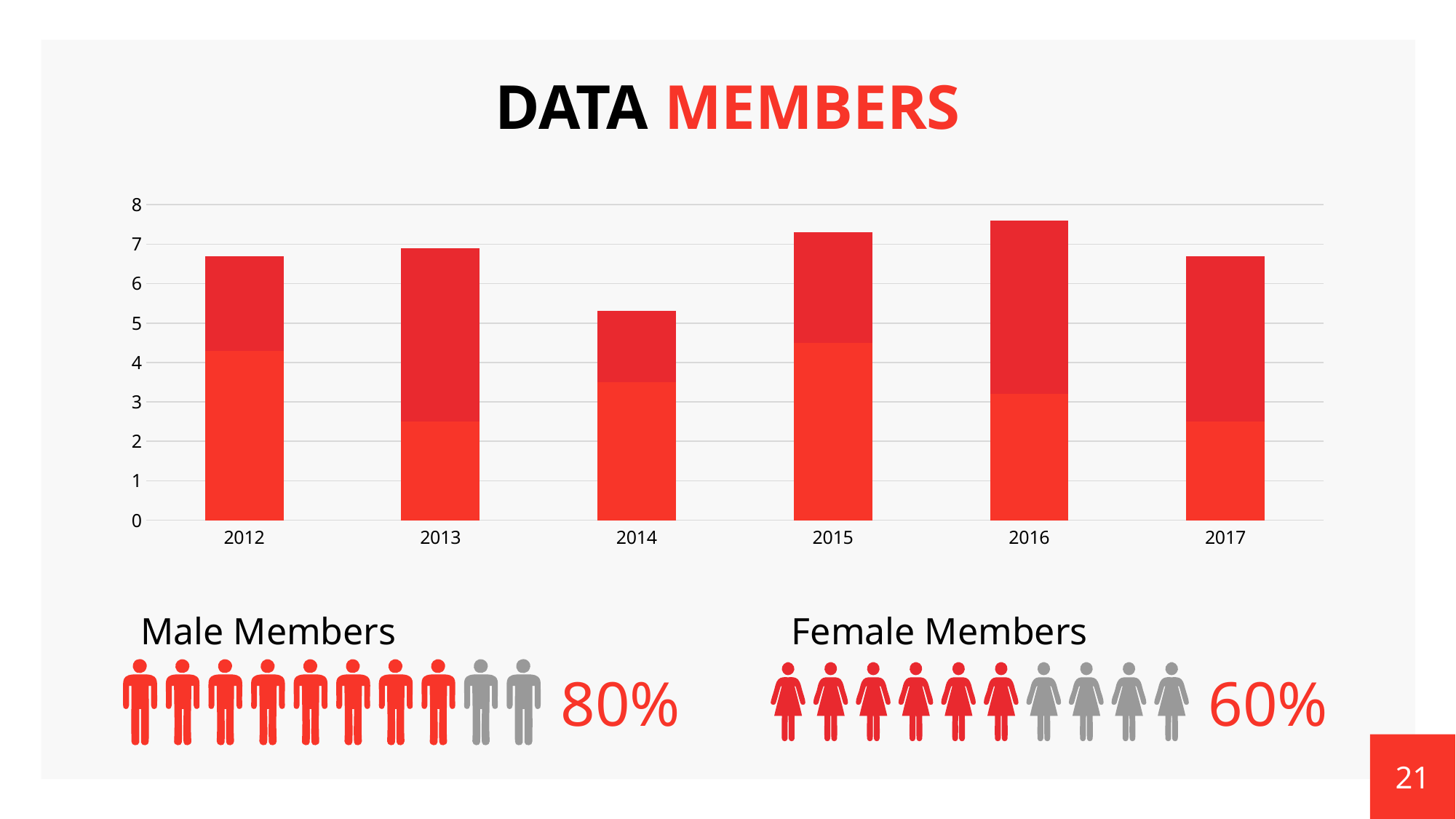
Is the lower (lighter red) segment of the 2013 bar greater or less than 3? less Is the lower (lighter red) segment of the 2015 bar greater or less than 4? greater Which year has the shortest bar in the chart? 2014 Which bar is taller, 2014 or 2015? 2015 How many years are shown on the x axis of the bar chart? 6 Do the bar heights rise or fall from 2014 to 2016? rise Is the total bar height for 2014 greater or less than 6? less What kind of chart is shown on the slide? Stacked bar chart Which year has the tallest bar in the chart? 2016 What is the title of the slide containing the chart? DATA MEMBERS